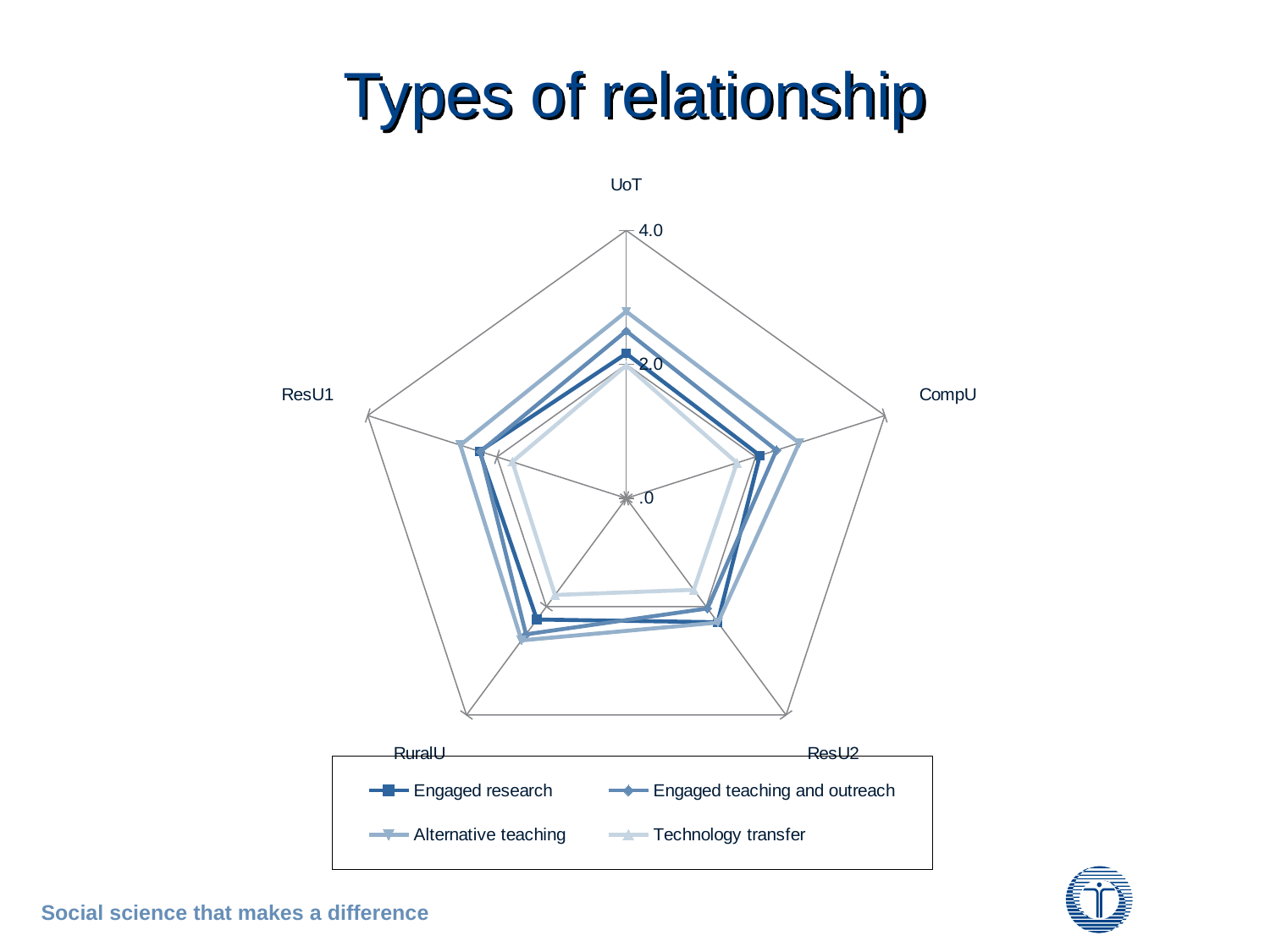
What kind of chart is shown on the slide? Radar chart How many categories (axes) does the radar chart have? 5 Is the value for Technology transfer at CompU greater or less than 2.0? less Which series has the highest value at UoT? Alternative teaching At UoT, which is larger: Alternative teaching or Technology transfer? Alternative teaching How many series does the legend list? 4 Which series is represented by the lightest line in the legend? Technology transfer Is the value for Alternative teaching at UoT greater or less than 2.0? greater Is the value for Alternative teaching at RuralU greater or less than 2.0? greater What is the title of the slide containing the chart? Types of relationship